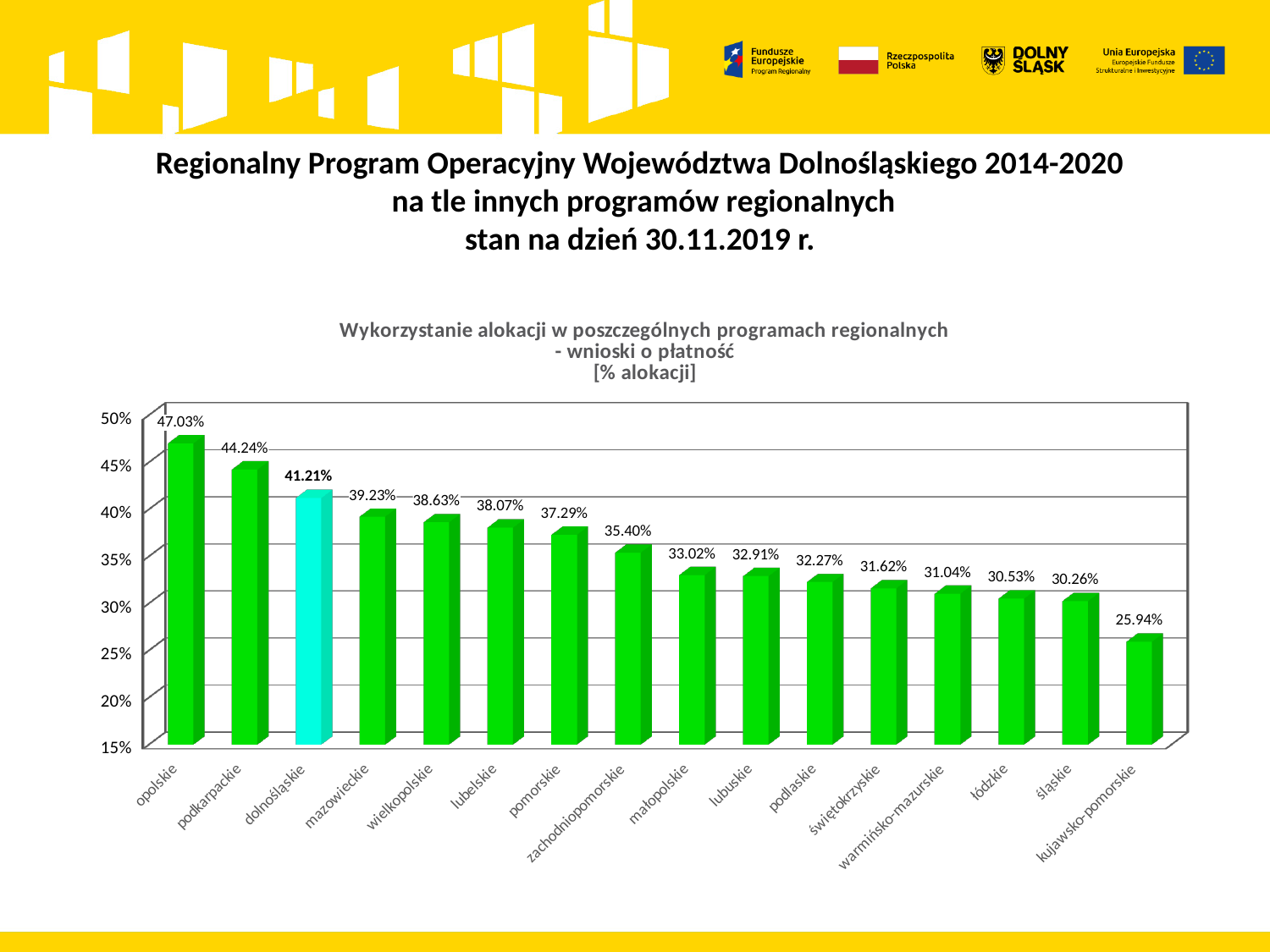
Which region has the lowest value? kujawsko-pomorskie What is the difference between the values for opolskie and dolnośląskie? 5.82 percentage points Which bar is highlighted in a different colour (cyan) from the others? dolnośląskie Which is larger, the value for lubelskie or the value for pomorskie? lubelskie Is the value for mazowieckie greater or less than 40%? less What is the difference between the values for podkarpackie and kujawsko-pomorskie? 18.30 percentage points What is the value for zachodniopomorskie? 35.40% Which region has the highest value? opolskie What is the value for warmińsko-mazurskie? 31.04% What is the value for dolnośląskie? 41.21% What kind of chart is shown on the slide? bar chart How many regions are shown on the chart? 16